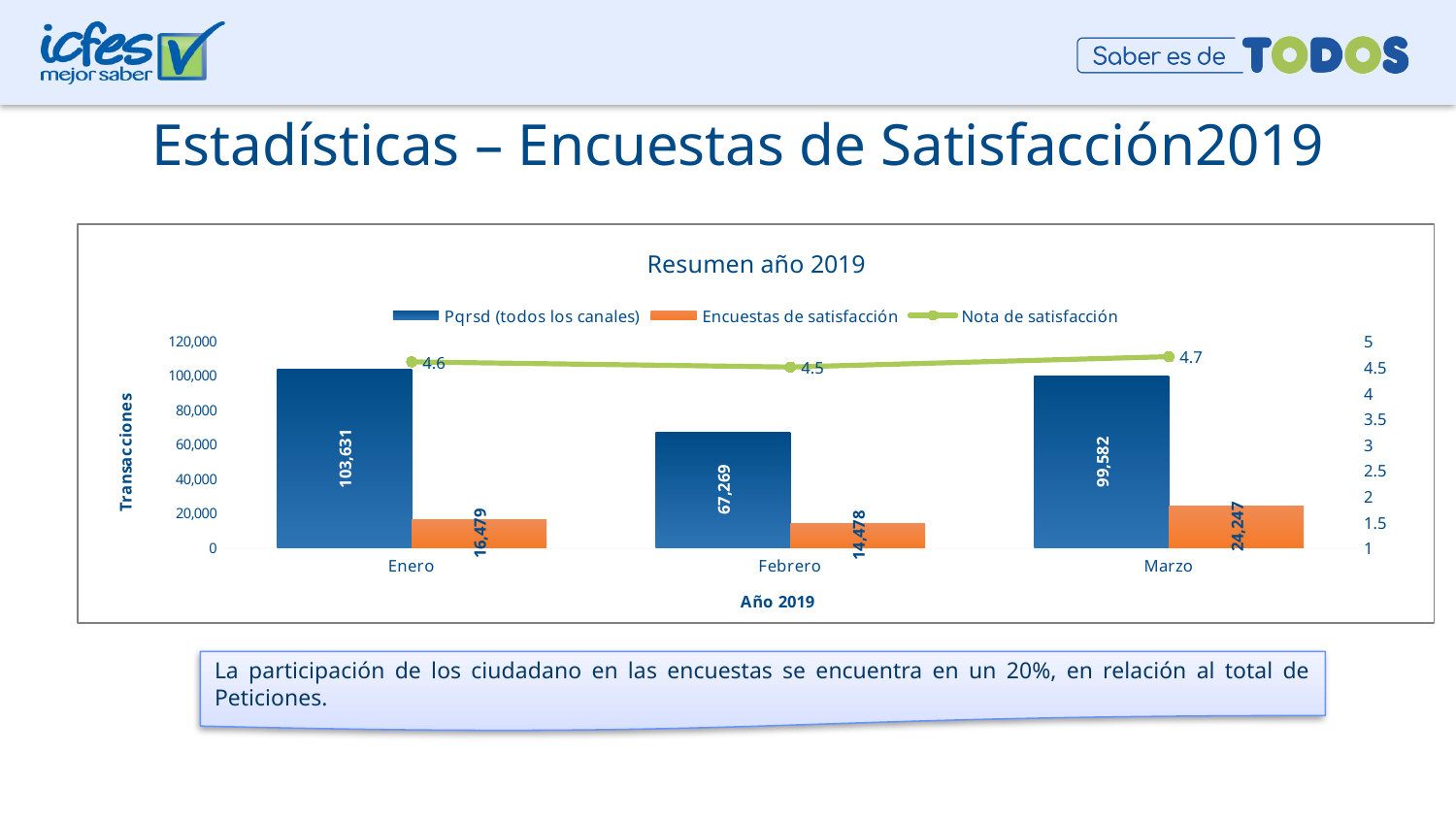
What is the value of Pqrsd (todos los canales) for Enero? 103,631 What is the label of the left vertical axis? Transacciones What is the Nota de satisfacción for Febrero? 4.5 What is the difference between the Pqrsd (todos los canales) values for Enero and Marzo? 4,049 What is the value of Encuestas de satisfacción for Marzo? 24,247 What is the title of the chart? Resumen año 2019 Which is larger, the Encuestas de satisfacción value for Enero or for Febrero? Enero How many series does the legend list? 3 How many months are shown on the x axis? 3 Does the Nota de satisfacción rise or fall from Febrero to Marzo? rise Which month has the lowest value for Pqrsd (todos los canales)? Febrero Which month has the highest value for Encuestas de satisfacción? Marzo